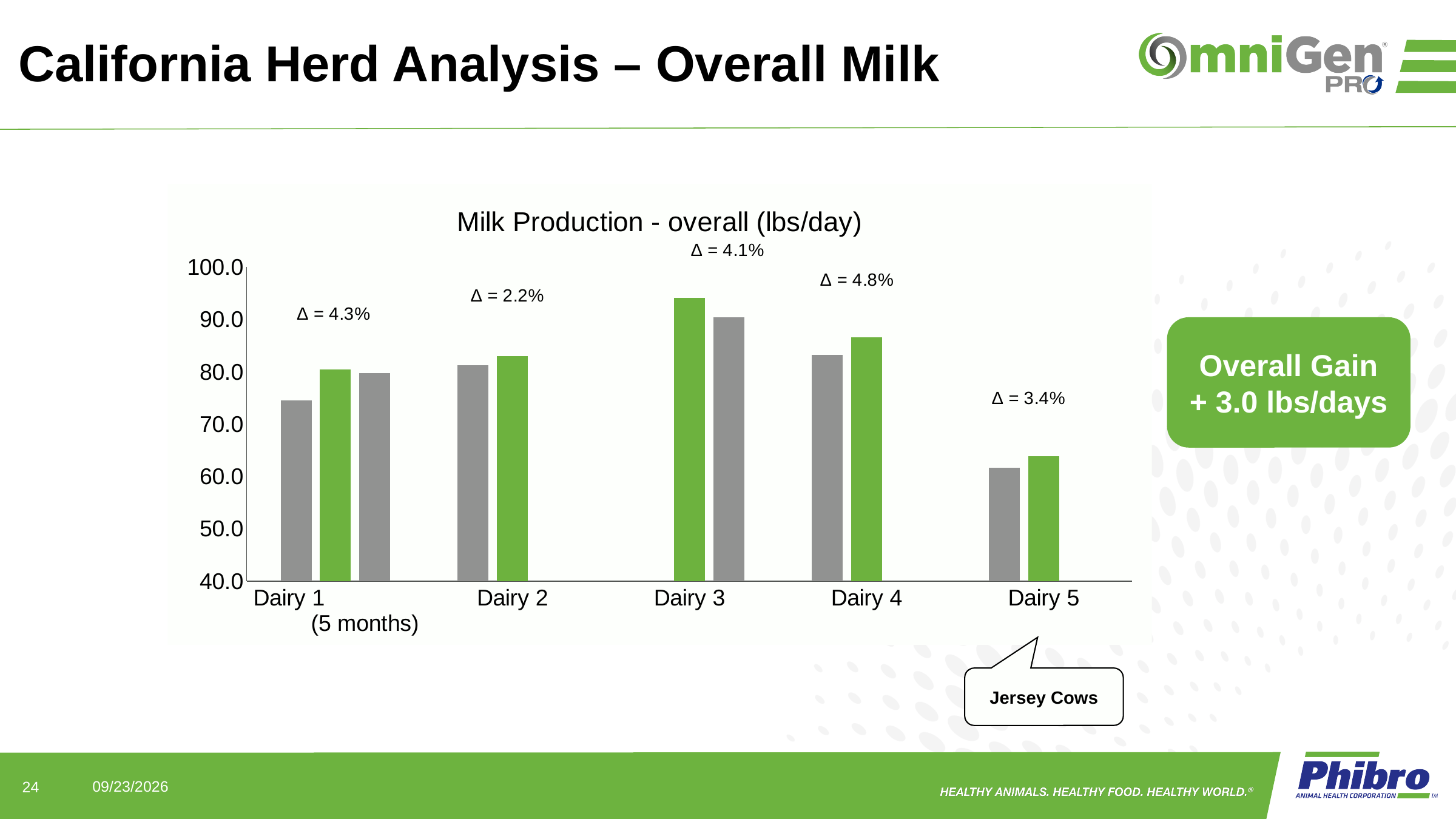
What is the Δ value shown above Dairy 1? Δ = 4.3% What is the difference between the Δ percentage for Dairy 4 and the Δ percentage for Dairy 2? 2.6% Which dairy has the tallest bars in the chart? Dairy 3 What is the title of the chart? Milk Production - overall (lbs/day) Is the value of the gray bar for Dairy 5 greater or less than 70.0? less What is the Δ value shown above Dairy 4? Δ = 4.8% How many dairies are shown on the x axis of the chart? 5 What kind of chart is shown on the slide? bar chart Is the value of the green bar for Dairy 3 greater or less than 90.0? greater Which dairy has the shortest bars in the chart? Dairy 5 Which dairy has the lowest Δ percentage? Dairy 2 Which dairy has the highest Δ percentage? Dairy 4